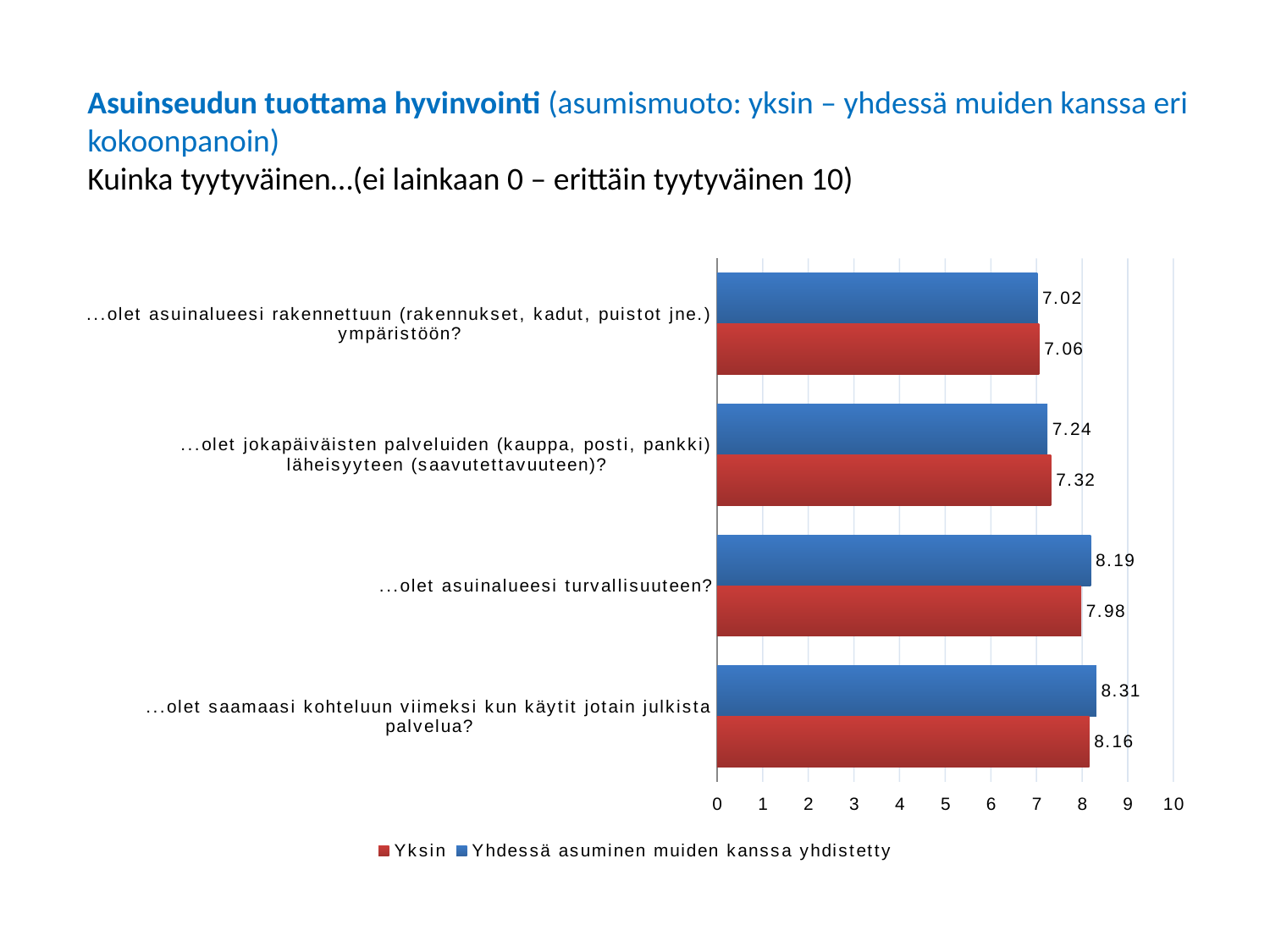
Is the Yksin value for "...olet asuinalueesi turvallisuuteen?" greater or less than 8? less What is the Yksin value for "...olet jokapäiväisten palveluiden (kauppa, posti, pankki) läheisyyteen (saavutettavuuteen)?"? 7.32 What is the Yksin value for "...olet asuinalueesi turvallisuuteen?"? 7.98 What kind of chart is shown on the slide? bar chart Which category has the highest "Yhdessä asuminen muiden kanssa yhdistetty" value? ...olet saamaasi kohteluun viimeksi kun käytit jotain julkista palvelua? What colour are the Yksin bars? red How many categories are shown on the chart? 4 What is the difference between the "Yhdessä asuminen muiden kanssa yhdistetty" and Yksin values for "...olet asuinalueesi turvallisuuteen?"? 0.21 Which category has the lowest Yksin value? ...olet asuinalueesi rakennettuun (rakennukset, kadut, puistot jne.) ympäristöön? What is the "Yhdessä asuminen muiden kanssa yhdistetty" value for "...olet saamaasi kohteluun viimeksi kun käytit jotain julkista palvelua?"? 8.31 For "...olet saamaasi kohteluun viimeksi kun käytit jotain julkista palvelua?", which series has the larger value, Yksin or "Yhdessä asuminen muiden kanssa yhdistetty"? Yhdessä asuminen muiden kanssa yhdistetty How many series does the legend list? 2